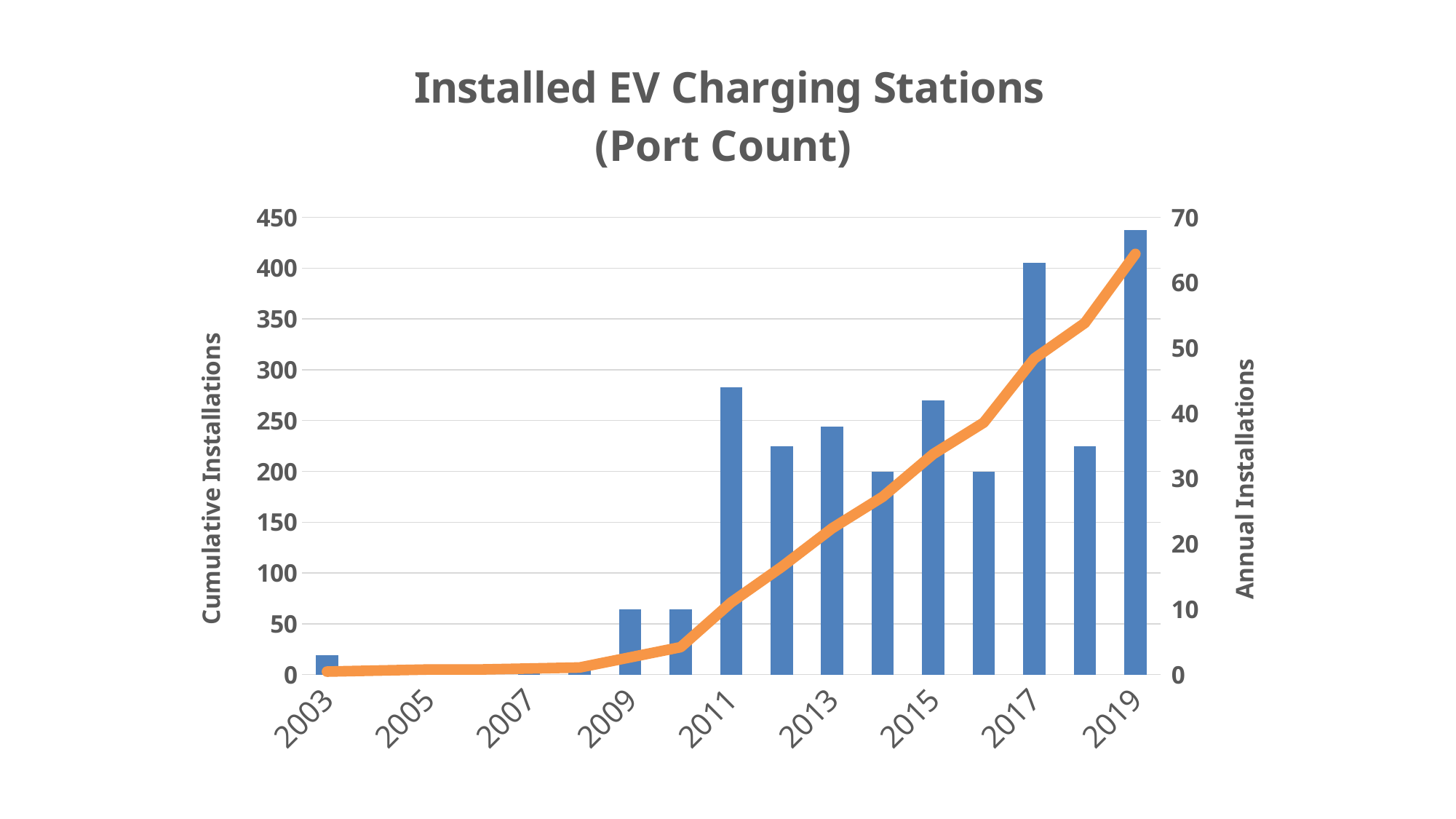
Which bar is taller, 2011 or 2013? 2011 What kind of chart is this? A combination bar and line chart Which bar is taller, 2015 or 2016? 2015 Which year has the tallest bar? 2019 Reading the bar for 2003 against the left axis, is its value greater or less than 50? less What is the title of the chart? Installed EV Charging Stations (Port Count) Does the orange line generally rise or fall from 2003 to 2019? Rise How many year labels are shown on the x axis? 9 What is the title of the left vertical axis? Cumulative Installations